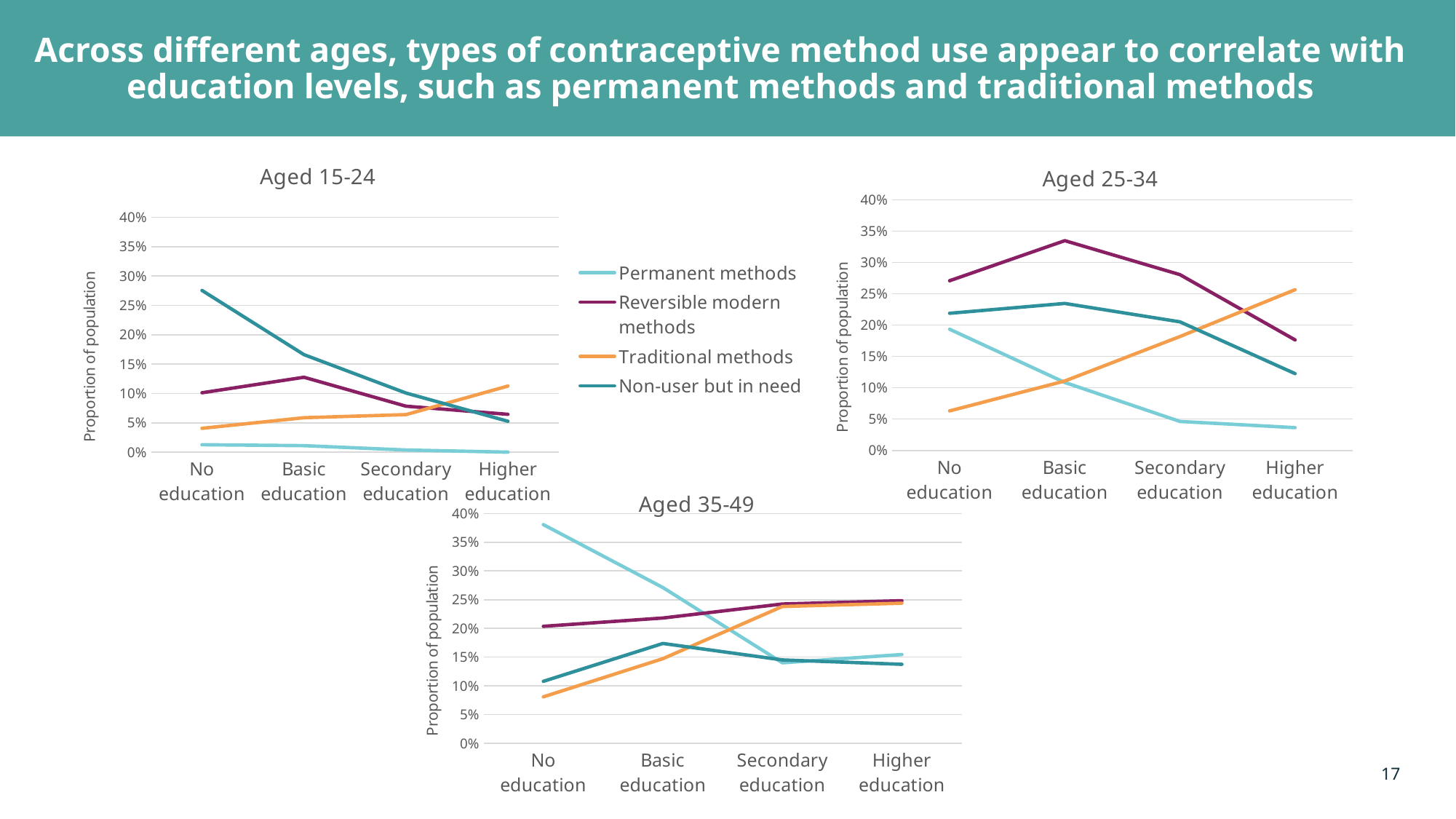
In the "Aged 15-24" chart, do the values for Non-user but in need rise or fall from No education to Higher education? fall In the "Aged 15-24" chart, is the value for Non-user but in need at No education greater or less than 25%? greater What kind of chart is the "Aged 15-24" chart? line chart In the "Aged 25-34" chart, at which education level is the value for Reversible modern methods highest? Basic education In the "Aged 15-24" chart, how many education categories are shown on the x axis? 4 How many series does the legend list? 4 In the "Aged 15-24" chart, which series has the lowest value at No education? Permanent methods In the "Aged 25-34" chart, do the values for Permanent methods rise or fall from No education to Higher education? fall In the "Aged 25-34" chart, is the value for Reversible modern methods at Basic education greater or less than 30%? greater In the "Aged 35-49" chart, is the value for Permanent methods at No education greater or less than 35%? greater In the "Aged 35-49" chart, at No education, which is larger: Permanent methods or Reversible modern methods? Permanent methods In the "Aged 15-24" chart, do the values for Traditional methods rise or fall from No education to Higher education? rise